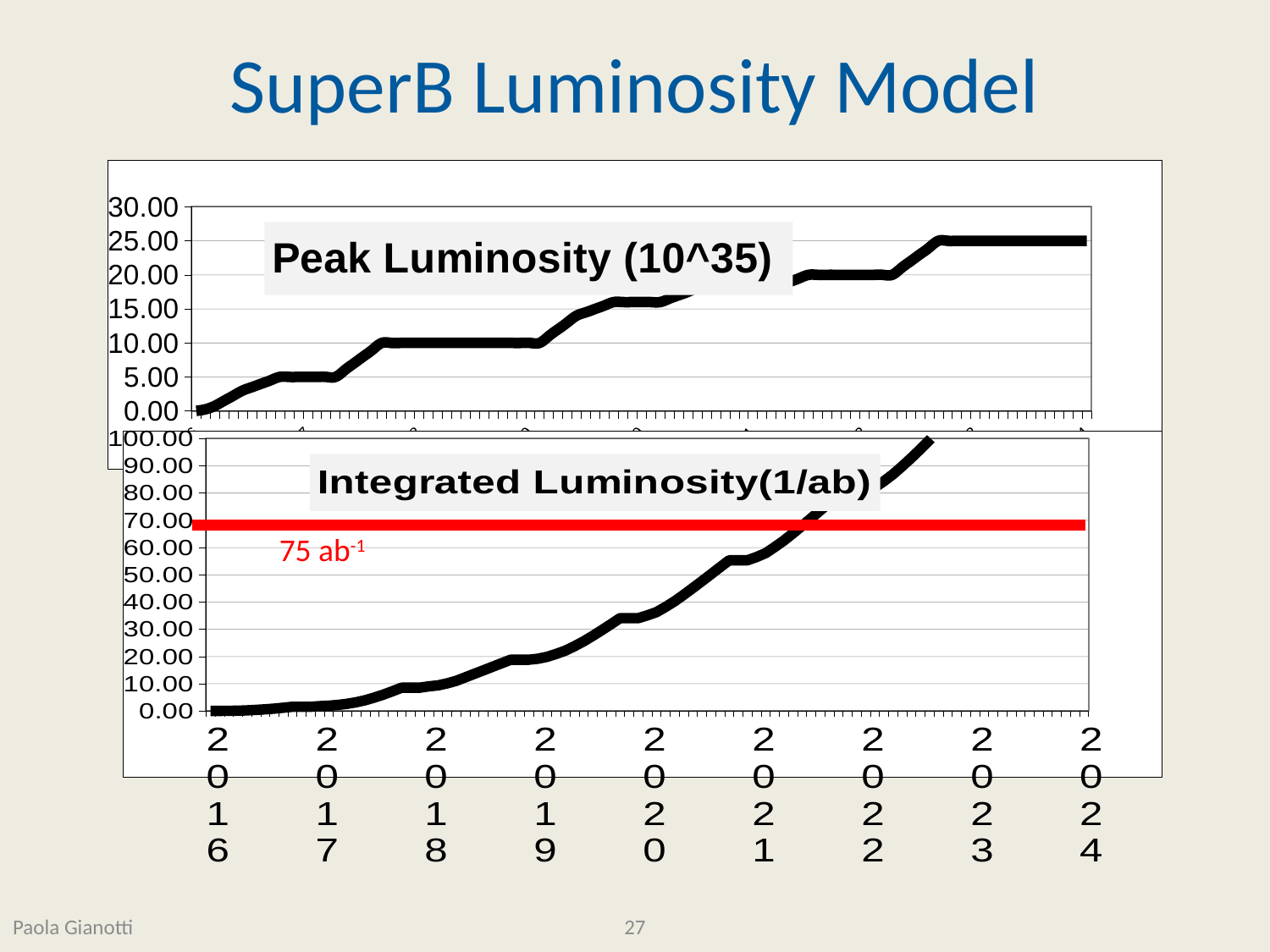
In the Peak Luminosity (10^35) chart, do the values rise or fall from 2016 to 2024? rise In the Integrated Luminosity(1/ab) chart, is the value for 2020 greater or less than 50? less In the Integrated Luminosity(1/ab) chart, is the value for 2024 greater or less than 90? greater In the Integrated Luminosity(1/ab) chart, is the value for 2019 greater or less than 30? less What kind of chart is the Integrated Luminosity(1/ab) chart? line chart What is the title of the top chart on the slide? Peak Luminosity (10^35) How many years are labelled on the x axis of the Integrated Luminosity(1/ab) chart? 9 What kind of chart is the Peak Luminosity (10^35) chart? line chart In the Integrated Luminosity(1/ab) chart, do the values rise or fall from 2016 to 2024? rise What label is written next to the red horizontal line in the Integrated Luminosity(1/ab) chart? 75 ab⁻¹